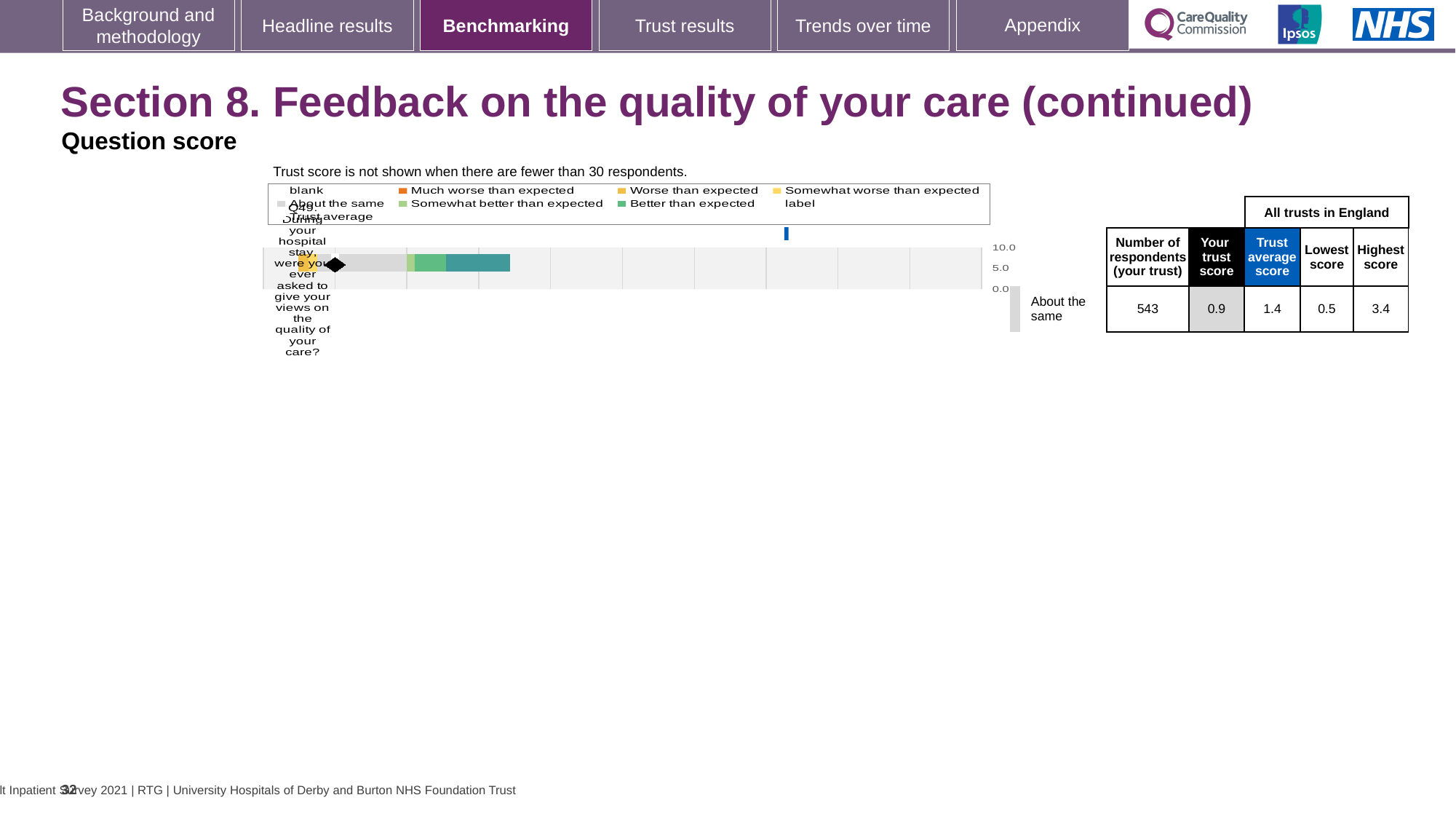
What is the trust average score for Q49 shown alongside the chart? 1.4 Which is larger for Q49: your trust score or the trust average score? Trust average score Is the trust score for Q49 greater or less than 5.0 on the axis? less Which question is plotted in the benchmarking chart? Q49. During your hospital stay, were you ever asked to give your views on the quality of your care? What is the lowest score across all trusts in England for Q49? 0.5 How many questions (categories) are plotted in the benchmarking chart? 1 What is the highest score across all trusts in England for Q49? 3.4 What is the difference between the highest score and the lowest score for Q49? 2.9 What is the trust score marked by the diamond on the Q49 bar? 0.9 How many respondents from your trust answered Q49? 543 What benchmarking category is the trust's Q49 result labelled as next to the chart? About the same What kind of chart is used to show the Q49 benchmarking result? bar chart